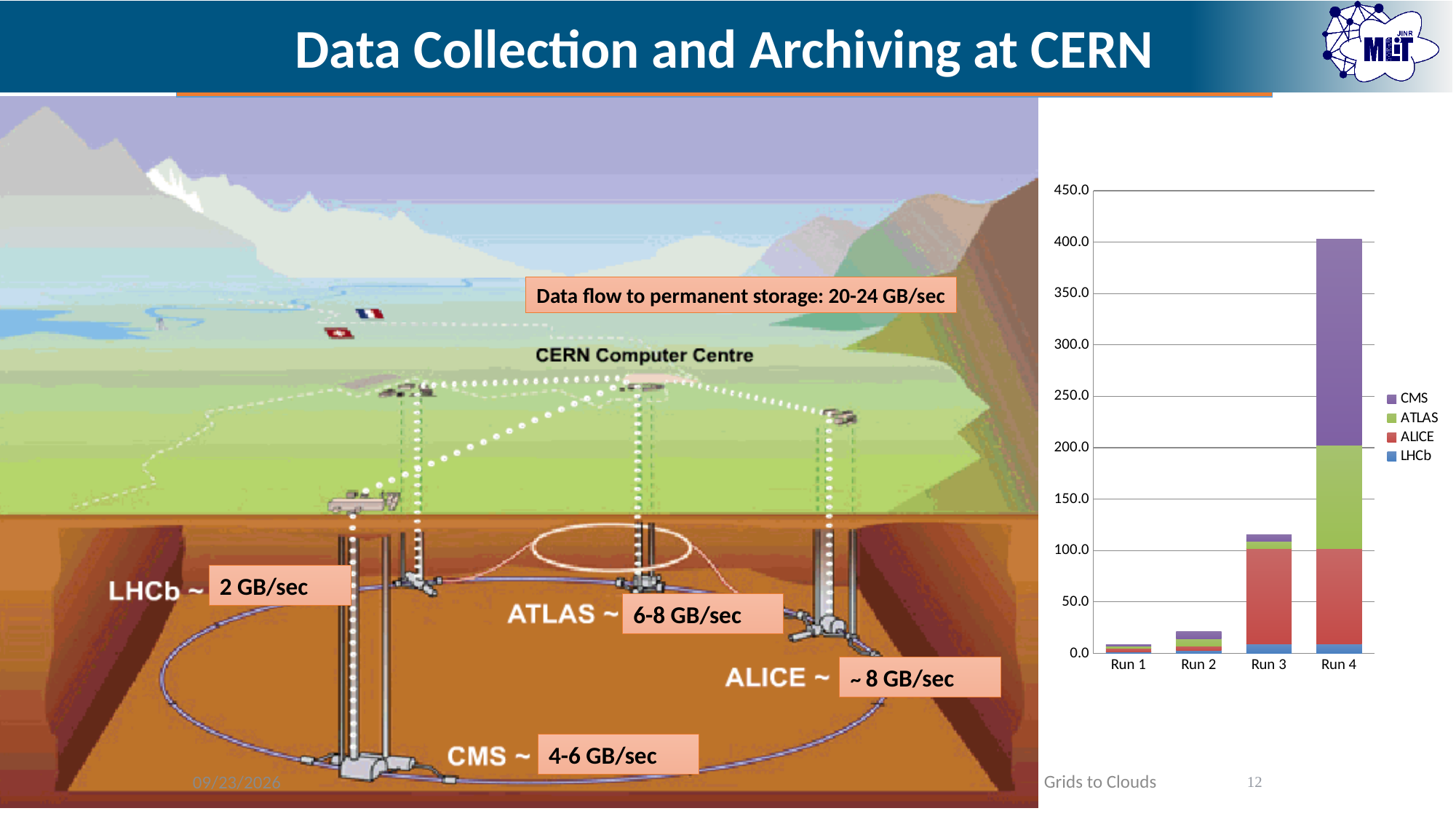
Which series contributes the largest segment to the Run 4 bar? CMS Is the total stacked value for Run 2 greater or less than 50? less Do the stacked bar totals rise or fall from Run 1 to Run 4? rise Which colour represents CMS in the bar chart legend? purple Is the total stacked value for Run 4 greater or less than 350? greater What kind of chart is shown on the right side of the slide? stacked bar chart Which run has the tallest stacked bar in the chart? Run 4 Which has the larger stacked bar total, Run 2 or Run 3? Run 3 How many series does the legend of the bar chart list? 4 Which run has the shortest stacked bar in the chart? Run 1 How many runs (categories) are shown on the x axis of the bar chart? 4 Is the total stacked value for Run 3 greater or less than 100? greater